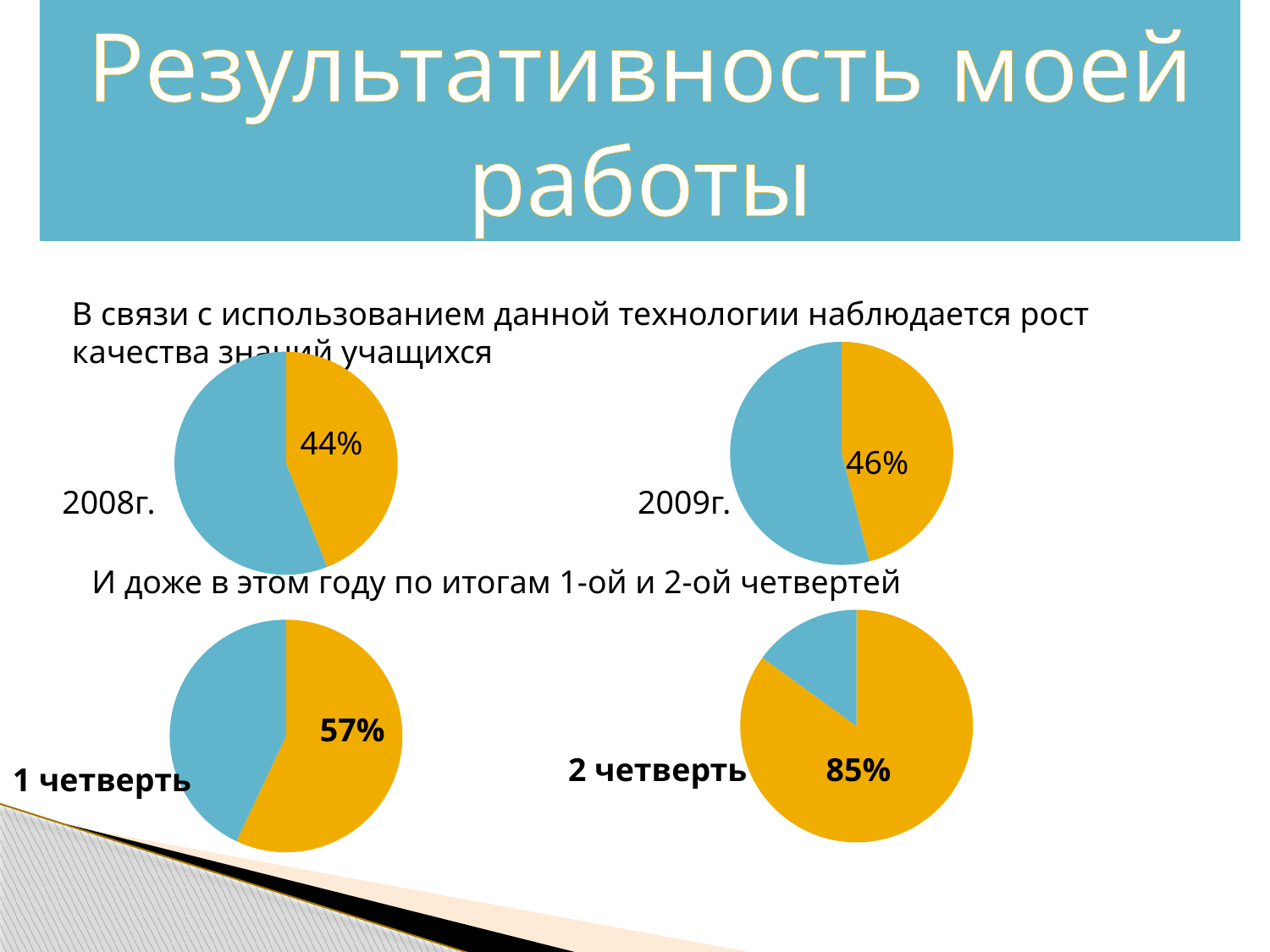
Which is larger: the labelled value in the 1 четверть pie chart or the labelled value in the 2 четверть pie chart? 2 четверть In the pie chart labelled 2008г., what value is printed on the orange slice? 44% In the pie chart labelled 2 четверть, what value is printed on the orange slice? 85% Which of the four pie charts on the slide has the smallest labelled orange slice? 2008г. In the pie chart labelled 2009г., what value is printed on the orange slice? 46% In the pie chart labelled 1 четверть, what value is printed on the orange slice? 57% What kind of chart is used for the 2008г. data on the slide? Pie chart How many pie charts are shown on the slide? 4 By how many percentage points does the labelled value in the 2 четверть pie chart exceed the labelled value in the 1 четверть pie chart? 28 By how many percentage points does the labelled value in the 2009г. pie chart exceed the labelled value in the 2008г. pie chart? 2 Which of the four pie charts on the slide has the largest labelled orange slice? 2 четверть How many slices does the 2 четверть pie chart have? 2